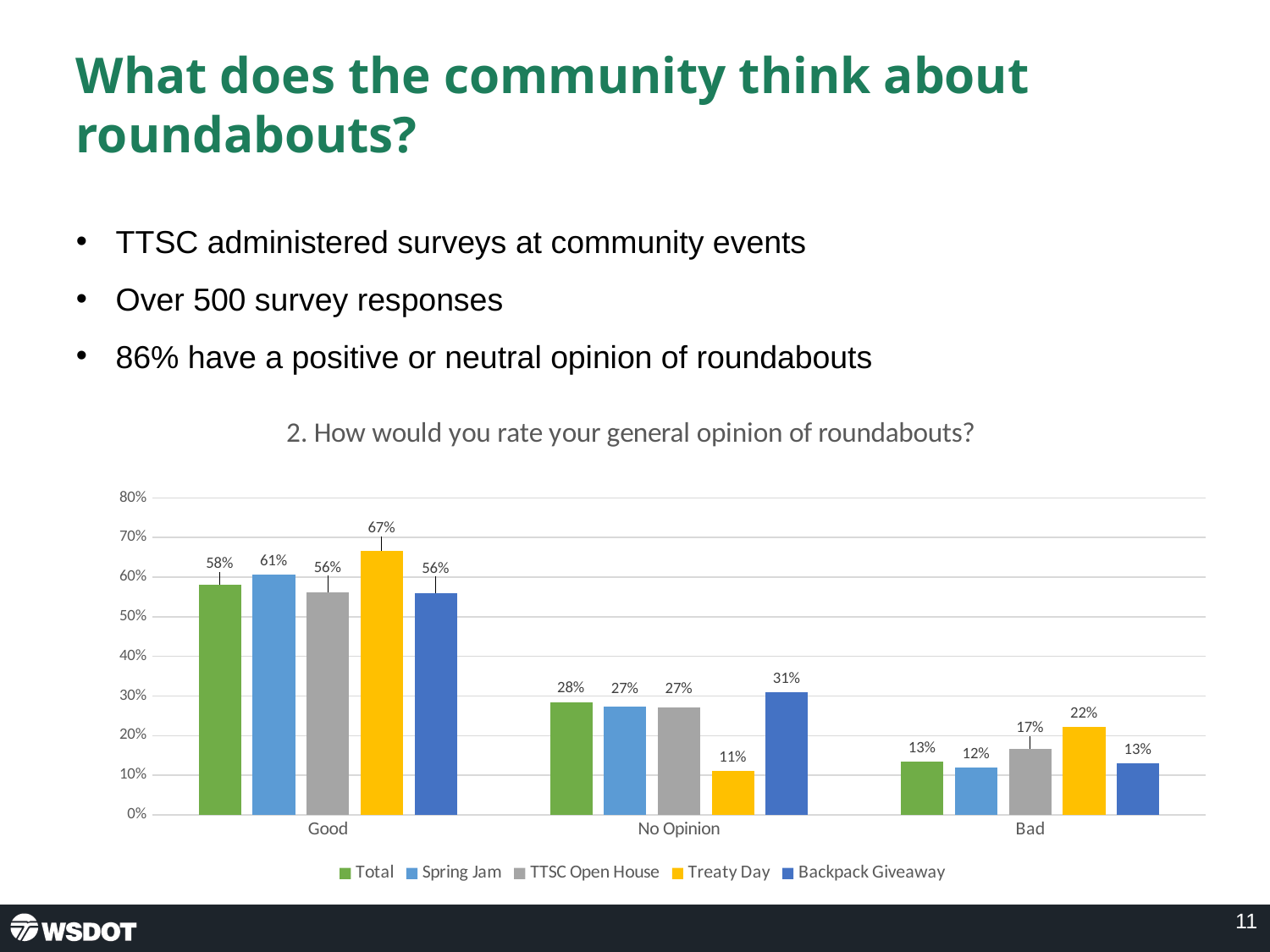
What is the Treaty Day value for the Good category? 67% What is the title of the chart? 2. How would you rate your general opinion of roundabouts? What is the Total value for the Bad category? 13% Do the Total values rise or fall from Good to Bad along the x axis? Fall What is the Backpack Giveaway value for the No Opinion category? 31% How many series does the legend list? 5 Which series has the highest value in the Good category? Treaty Day Which series has the lowest value in the No Opinion category? Treaty Day How many categories are shown on the x axis? 3 Which is larger in the Good category, Spring Jam or TTSC Open House? Spring Jam What is the difference between the Treaty Day and Total values in the Bad category? 9% What kind of chart is shown on the slide? Bar chart